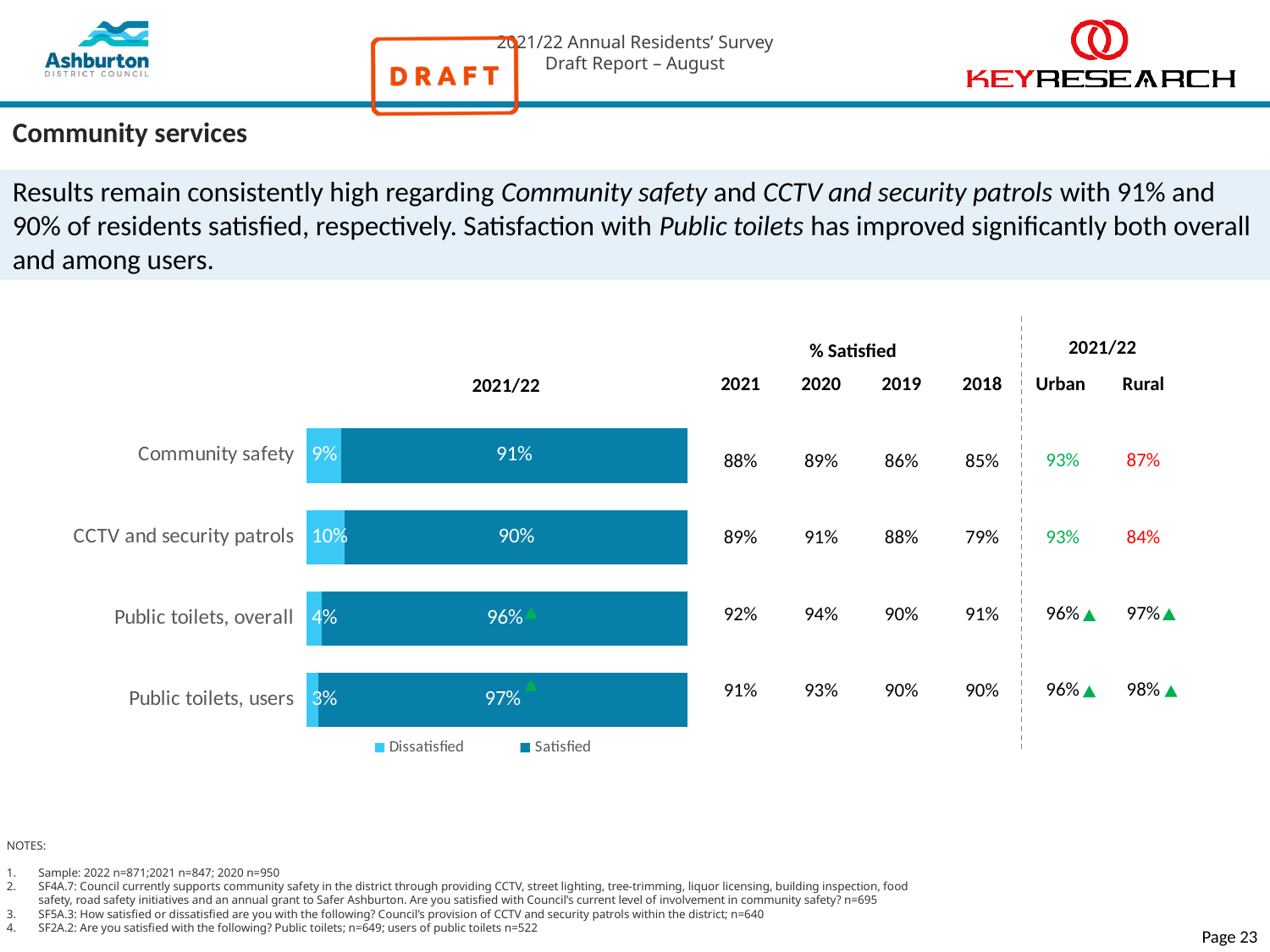
What is the Dissatisfied value for CCTV and security patrols in the 2021/22 chart? 10% Which has the larger Dissatisfied value in the 2021/22 chart: Community safety or Public toilets, overall? Community safety What kind of chart is the 2021/22 chart? Stacked bar chart What is the Satisfied value for Community safety in the 2021/22 chart? 91% Which category has the highest Satisfied value in the 2021/22 chart? Public toilets, users Which category has the lowest Satisfied value in the 2021/22 chart? CCTV and security patrols What is the difference between the Satisfied values for Public toilets, users and Community safety in the 2021/22 chart? 6% What are the legend entries in the 2021/22 chart? Dissatisfied, Satisfied Which category has the highest Dissatisfied value in the 2021/22 chart? CCTV and security patrols What is the Dissatisfied value for Public toilets, users in the 2021/22 chart? 3% How many categories are shown in the 2021/22 chart? 4 How many series does the legend of the 2021/22 chart list? 2